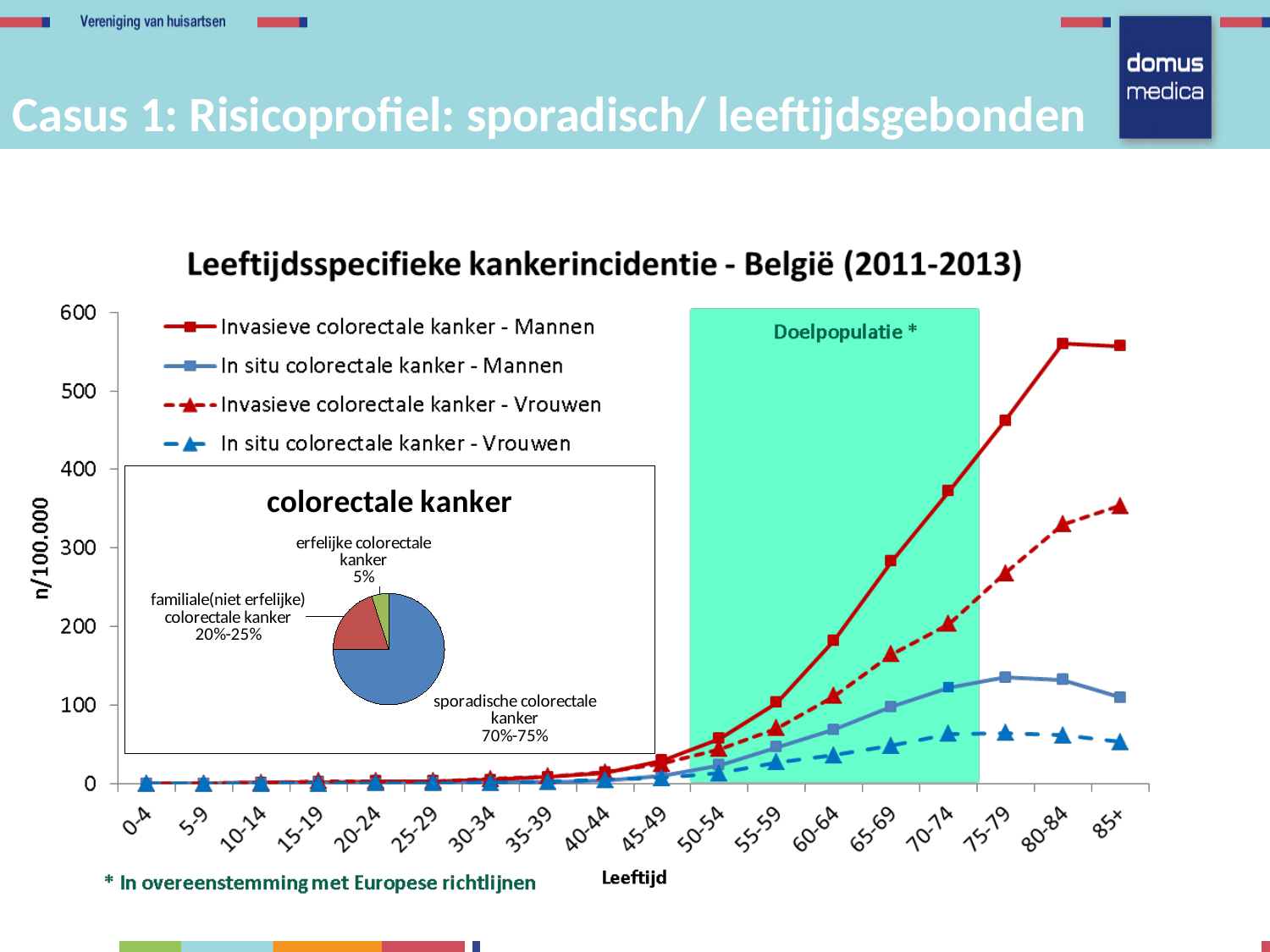
In the line chart 'Leeftijdsspecifieke kankerincidentie - België (2011-2013)', what is the label of the shaded green region? Doelpopulatie * In the line chart 'Leeftijdsspecifieke kankerincidentie - België (2011-2013)', is the value for 'In situ colorectale kanker - Vrouwen' at 85+ greater or less than 100? less In the line chart 'Leeftijdsspecifieke kankerincidentie - België (2011-2013)', does 'Invasieve colorectale kanker - Mannen' generally rise or fall from 40-44 to 80-84? rise In the line chart 'Leeftijdsspecifieke kankerincidentie - België (2011-2013)', how many series does the legend list? 4 In the pie chart 'colorectale kanker', which slice is the largest? sporadische colorectale kanker In the line chart 'Leeftijdsspecifieke kankerincidentie - België (2011-2013)', is the value for 'Invasieve colorectale kanker - Mannen' at 80-84 greater or less than 500? greater In the line chart 'Leeftijdsspecifieke kankerincidentie - België (2011-2013)', which series reaches the highest value? Invasieve colorectale kanker - Mannen In the pie chart 'colorectale kanker', what share is 'erfelijke colorectale kanker'? 5% In the line chart 'Leeftijdsspecifieke kankerincidentie - België (2011-2013)', what kind of chart is it? line chart In the line chart 'Leeftijdsspecifieke kankerincidentie - België (2011-2013)', how many age categories are shown on the x axis? 18 In the line chart 'Leeftijdsspecifieke kankerincidentie - België (2011-2013)', at 75-79, which is larger: 'Invasieve colorectale kanker - Mannen' or 'Invasieve colorectale kanker - Vrouwen'? Invasieve colorectale kanker - Mannen In the line chart 'Leeftijdsspecifieke kankerincidentie - België (2011-2013)', is the value for 'Invasieve colorectale kanker - Vrouwen' at 85+ greater or less than 400? less